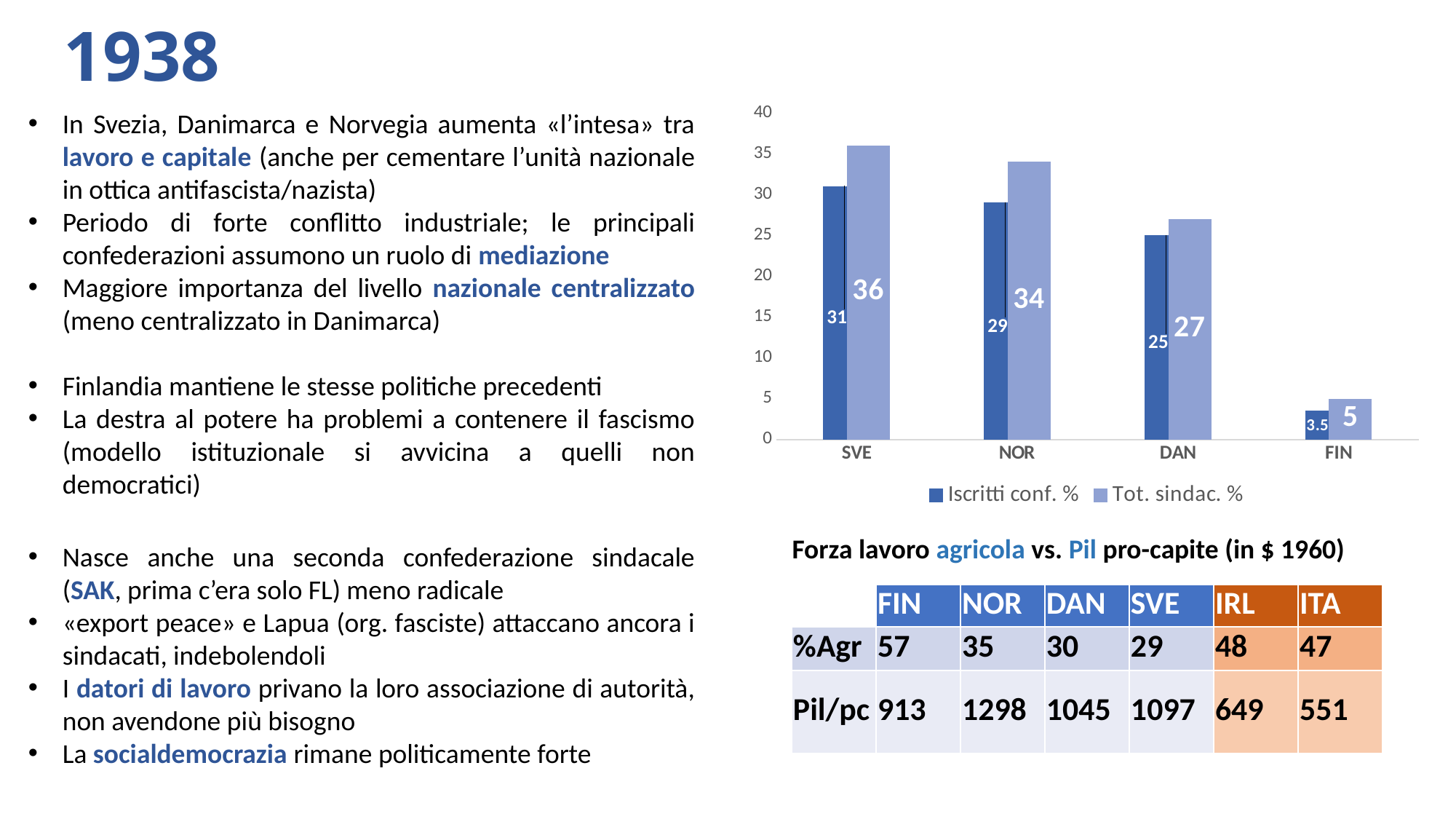
What type of chart is shown on the slide? bar chart What is the value of Tot. sindac. % for DAN? 27 What is the value of Iscritti conf. % for FIN? 3.5 How many series does the legend of the bar chart list? 2 What is the difference between Tot. sindac. % and Iscritti conf. % for NOR? 5 Which is larger: Iscritti conf. % for DAN or Iscritti conf. % for NOR? Iscritti conf. % for NOR How many countries are shown on the x axis of the bar chart? 4 What is the value of Iscritti conf. % for SVE? 31 Which country has the lowest Iscritti conf. % value? FIN What is the value of Tot. sindac. % for NOR? 34 Which country has the highest Tot. sindac. % value? SVE Do the Tot. sindac. % values rise or fall from SVE to FIN along the x axis? fall